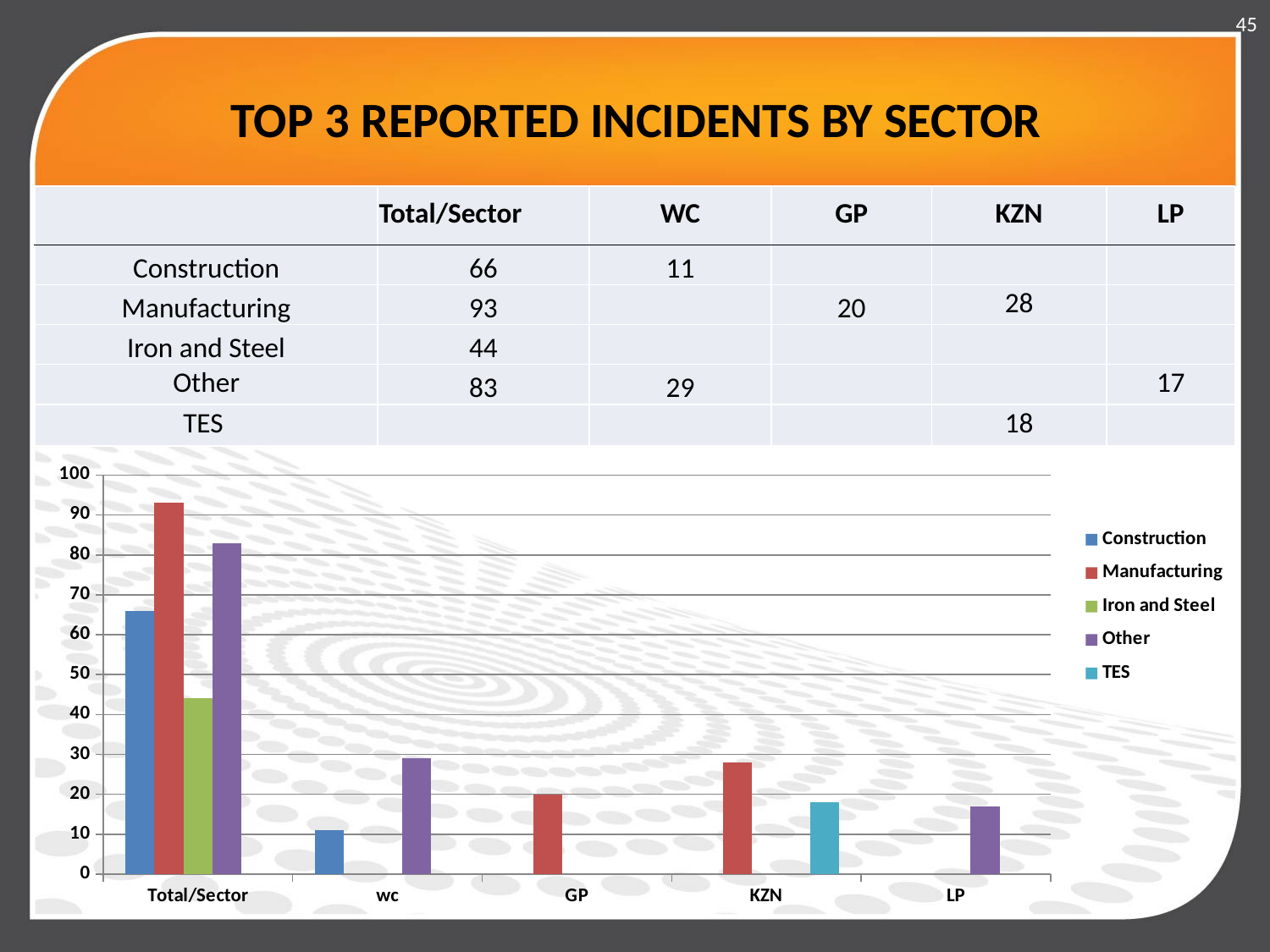
What is the value for Other in WC? 29 What is the difference between the Total/Sector values for Manufacturing and Other? 10 Is the Construction value in WC greater or less than 20? less What is the value for TES in KZN? 18 Which sector has the lowest Total/Sector value? Iron and Steel What kind of chart is shown on the slide? bar chart How many series does the chart legend list? 5 What is the Total/Sector value for Manufacturing? 93 How many categories are shown along the x axis of the chart? 5 Which colour represents Iron and Steel in the chart legend? green Which is larger: the Manufacturing value in KZN or the Manufacturing value in GP? KZN Which sector has the highest Total/Sector value? Manufacturing